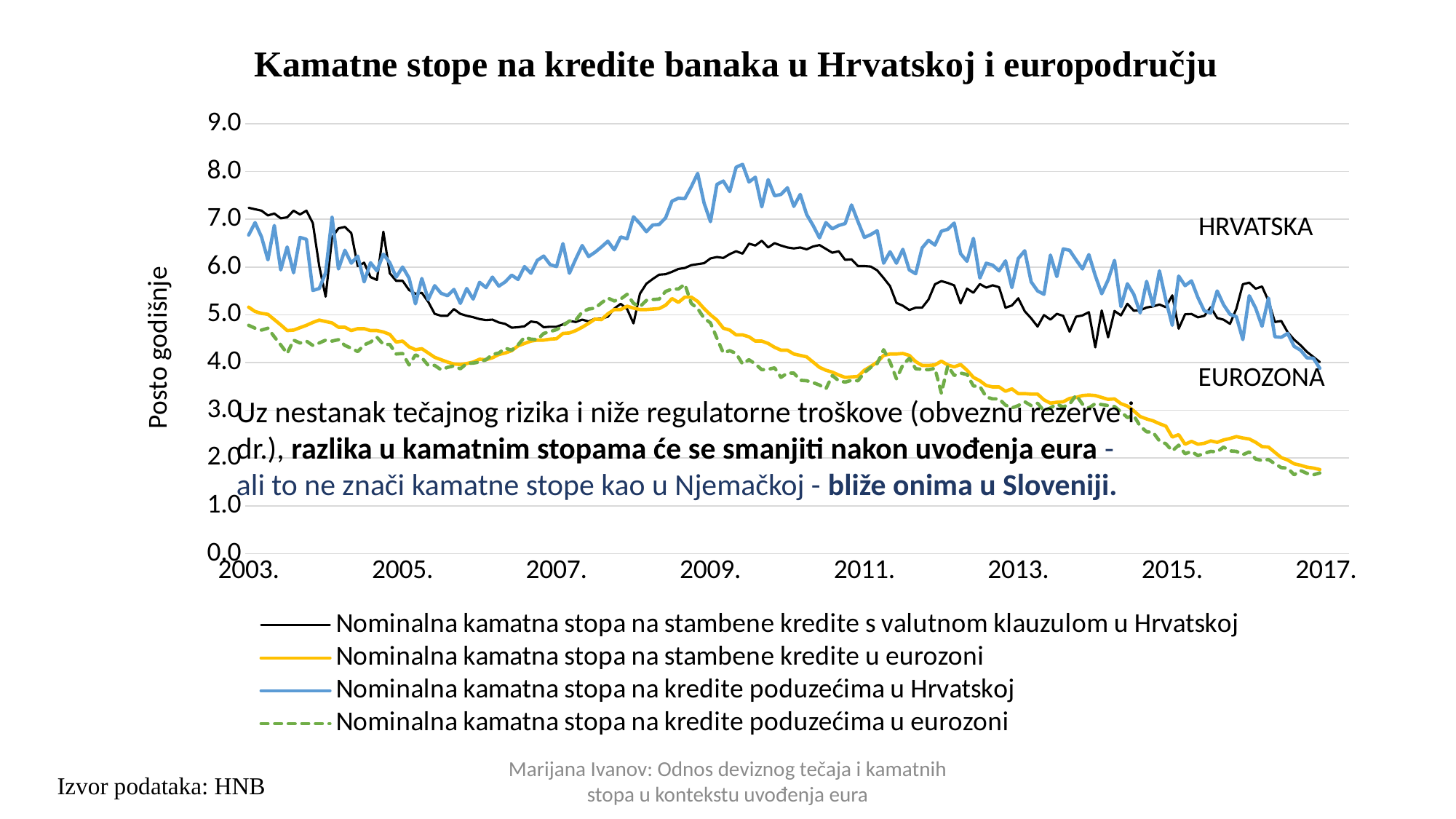
What kind of chart is shown on the slide? line chart Which series is drawn as a dashed line? Nominalna kamatna stopa na kredite poduzećima u eurozoni At the end of the series in 2017, which is higher: the nominal interest rate on housing loans in Croatia or in the eurozone? Croatia Does the nominal interest rate on housing loans in the eurozone rise or fall between 2009 and 2017? fall Is the nominal interest rate on housing loans in the eurozone at the end of 2017 greater or less than 3.0? less Is the peak value of the nominal interest rate on loans to enterprises in Croatia around 2009 greater or less than 7.0? greater Is the nominal interest rate on housing loans with a currency clause in Croatia at the start of 2003 greater or less than 6.0? greater What is the title of the chart? Kamatne stope na kredite banaka u Hrvatskoj i europodručju How many series does the legend list? 4 Around 2009, which is higher: the nominal interest rate on loans to enterprises in Croatia or the nominal interest rate on housing loans with a currency clause in Croatia? loans to enterprises in Croatia Does the nominal interest rate on housing loans with a currency clause in Croatia rise or fall overall between 2013 and 2017? fall